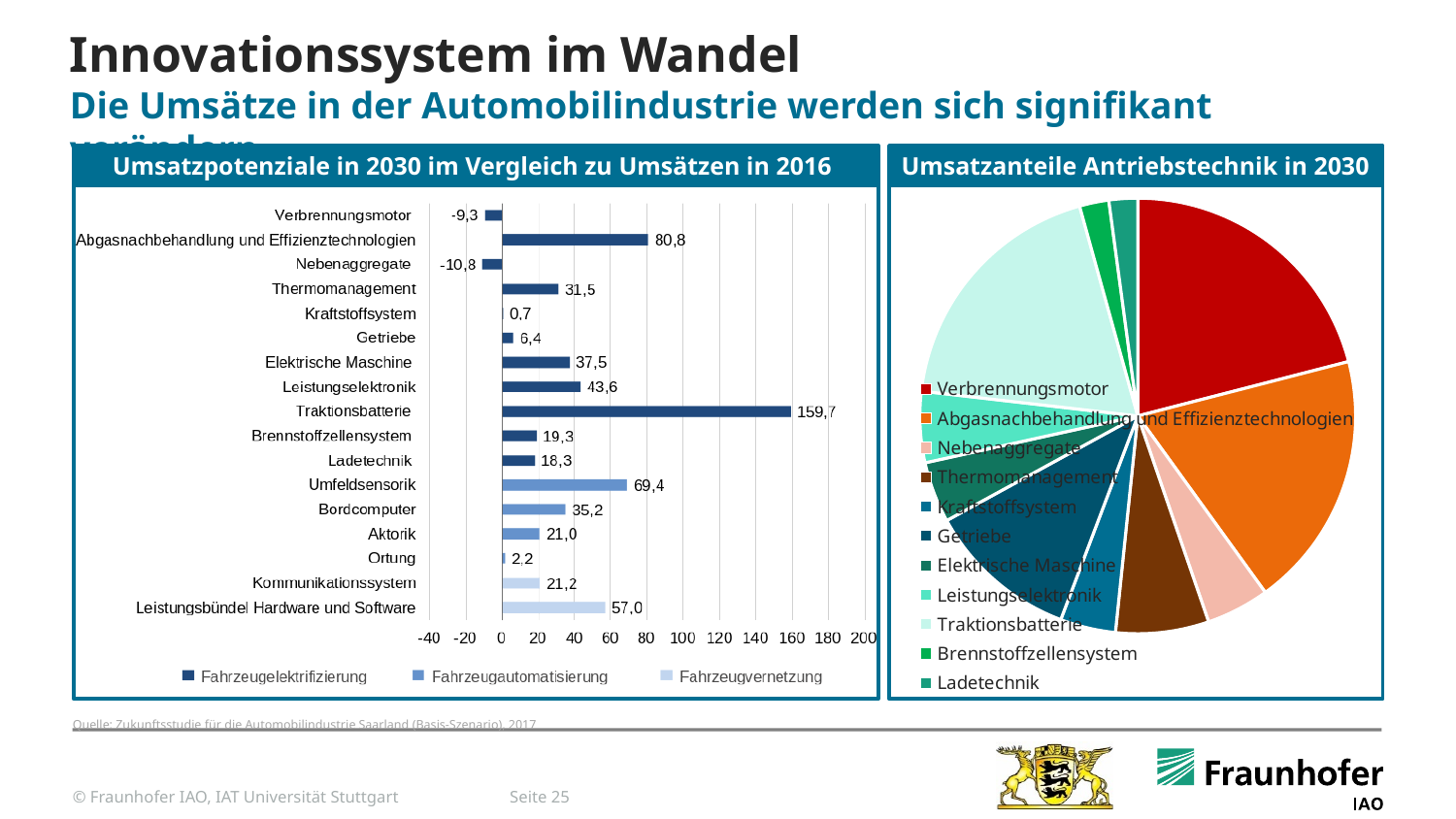
In the chart "Umsatzpotenziale in 2030 im Vergleich zu Umsätzen in 2016", what is the value for Traktionsbatterie? 159,7 How many series does the legend of the chart "Umsatzpotenziale in 2030 im Vergleich zu Umsätzen in 2016" list? 3 What kind of chart is the chart titled "Umsatzpotenziale in 2030 im Vergleich zu Umsätzen in 2016"? bar chart What kind of chart is the chart titled "Umsatzanteile Antriebstechnik in 2030"? pie chart In the chart "Umsatzpotenziale in 2030 im Vergleich zu Umsätzen in 2016", which category has the highest value? Traktionsbatterie How many categories are shown in the chart "Umsatzpotenziale in 2030 im Vergleich zu Umsätzen in 2016"? 17 In the chart "Umsatzpotenziale in 2030 im Vergleich zu Umsätzen in 2016", what is the value for Ortung? 2,2 In the chart "Umsatzpotenziale in 2030 im Vergleich zu Umsätzen in 2016", which category has the lowest value? Nebenaggregate In the chart "Umsatzpotenziale in 2030 im Vergleich zu Umsätzen in 2016", what is the difference between the values for Abgasnachbehandlung und Effizienztechnologien and Umfeldsensorik? 11,4 How many entries does the legend of the chart "Umsatzanteile Antriebstechnik in 2030" list? 11 In the chart "Umsatzpotenziale in 2030 im Vergleich zu Umsätzen in 2016", what is the value for Kommunikationssystem? 21,2 In the chart "Umsatzpotenziale in 2030 im Vergleich zu Umsätzen in 2016", which is larger: Elektrische Maschine or Leistungselektronik? Leistungselektronik